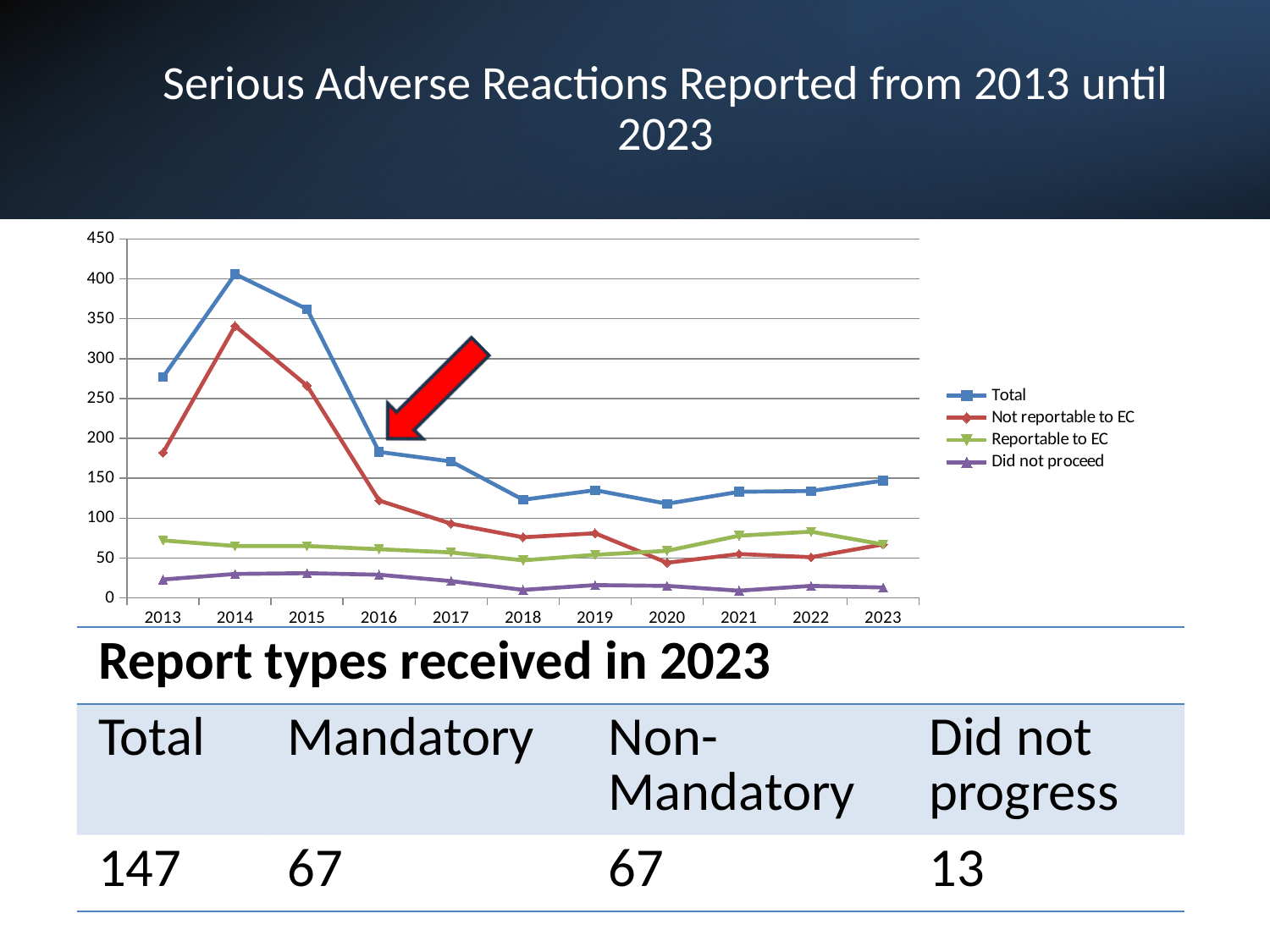
In which year does the Not reportable to EC series reach its highest value? 2014 Is the value for Total in 2013 greater or less than 250? greater How many years are plotted along the x axis of the chart? 11 Does the Total series rise or fall between 2014 and 2018? fall Is the value for Not reportable to EC in 2016 greater or less than 100? greater In which year does the Total series reach its highest value? 2014 Is the value for Did not proceed in 2018 greater or less than 50? less How many series does the chart legend list? 4 Which is larger, the Total value in 2013 or the Total value in 2015? 2015 According to the slide, what was the Total number of reports received in 2023? 147 What kind of chart is shown on the slide? line chart